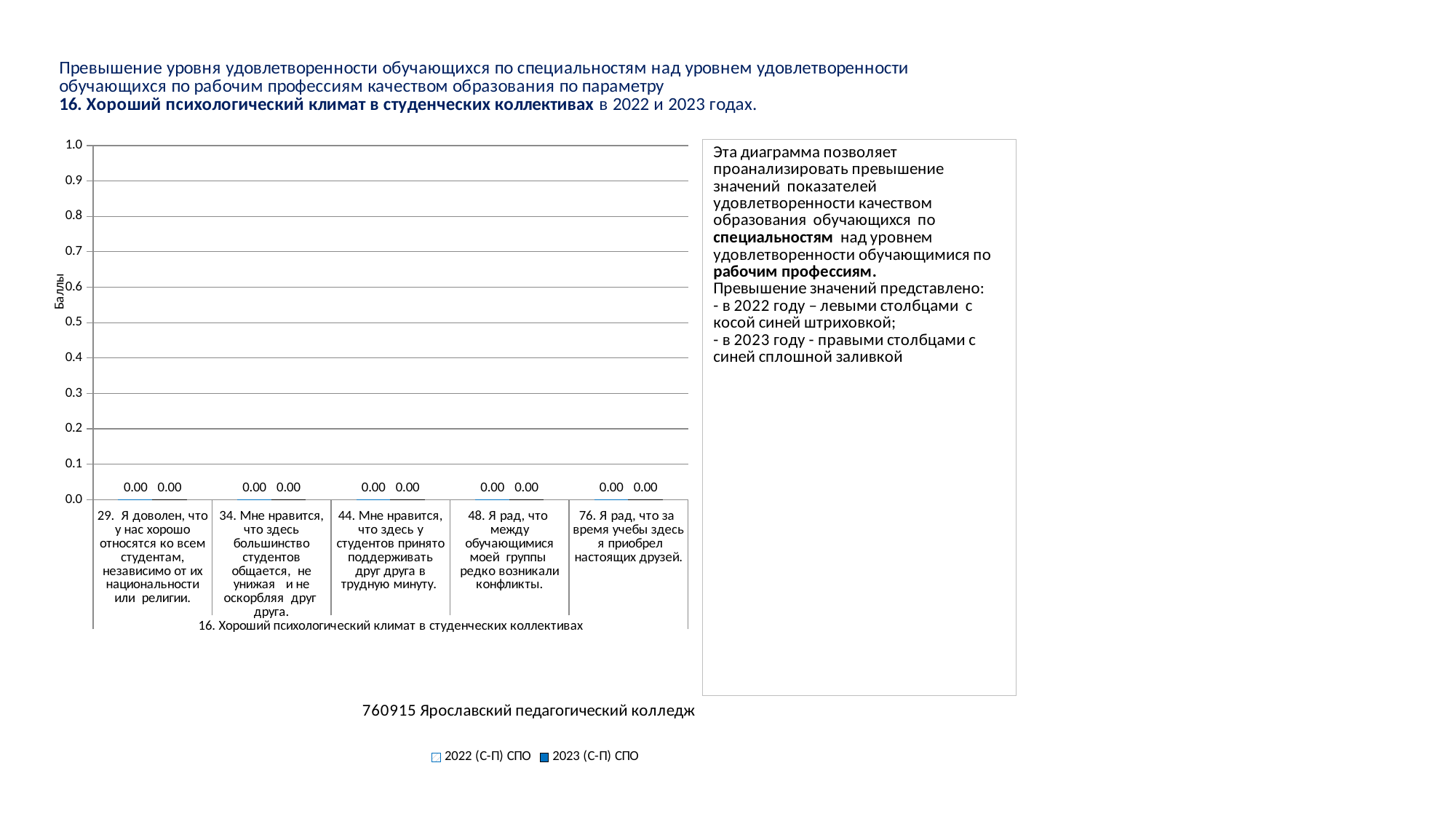
Do the values for the 2023 (С-П) СПО series rise, fall, or stay the same across the categories? stay the same Is the value for the 2022 (С-П) СПО series for category 34 greater or less than 0.1? less What is the value for the 2023 (С-П) СПО series for category 76 ("Я рад, что за время учебы здесь я приобрел настоящих друзей")? 0.00 What is the difference between the 2022 (С-П) СПО and 2023 (С-П) СПО values for category 48 ("Я рад, что между обучающимися моей группы редко возникали конфликты")? 0.00 What is the label of the vertical axis of the chart? Баллы What is the title of the chart? 760915 Ярославский педагогический колледж How many series does the chart legend list? 2 What kind of chart is shown on the slide? bar chart What is the value for the 2022 (С-П) СПО series for category 29 ("Я доволен, что у нас хорошо относятся ко всем студентам...")? 0.00 How many categories are shown on the x axis of the chart? 5 What is the value for the 2023 (С-П) СПО series for category 44 ("Мне нравится, что здесь у студентов принято поддерживать друг друга в трудную минуту")? 0.00